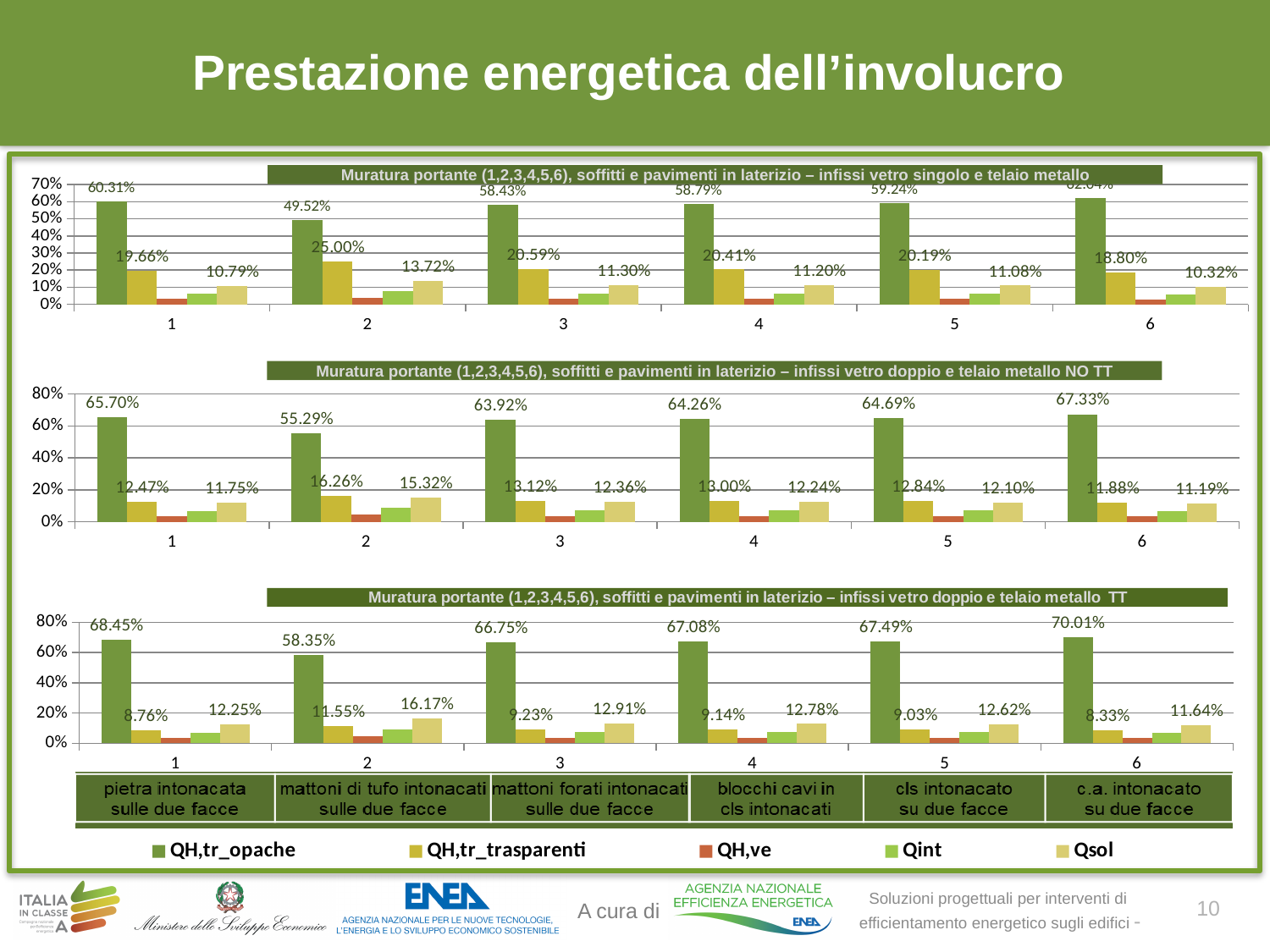
What kind of chart is the middle chart? bar chart In the middle chart (infissi vetro doppio e telaio metallo NO TT), which category has the highest Qsol value? 2 How many series does the legend list? 5 How many categories are shown on the x axis of the bottom chart? 6 In the top chart (infissi vetro singolo e telaio metallo), what is the QH,tr_trasparenti value for category 2? 25.00% In the bottom chart (infissi vetro doppio e telaio metallo TT), what is the QH,tr_opache value for category 6? 70.01% In the top chart (infissi vetro singolo e telaio metallo), what is the QH,tr_opache value for category 1? 60.31% In the bottom chart (infissi vetro doppio e telaio metallo TT), which is larger for category 3: QH,tr_trasparenti or Qsol? Qsol In the bottom chart (infissi vetro doppio e telaio metallo TT), is the QH,ve value for category 1 greater or less than 20%? less In the top chart (infissi vetro singolo e telaio metallo), which category has the lowest QH,tr_opache value? 2 In the middle chart (infissi vetro doppio e telaio metallo NO TT), what is the QH,tr_opache value for category 6? 67.33% In the middle chart (infissi vetro doppio e telaio metallo NO TT), what is the difference between the QH,tr_opache values for category 1 and category 2? 10.41%